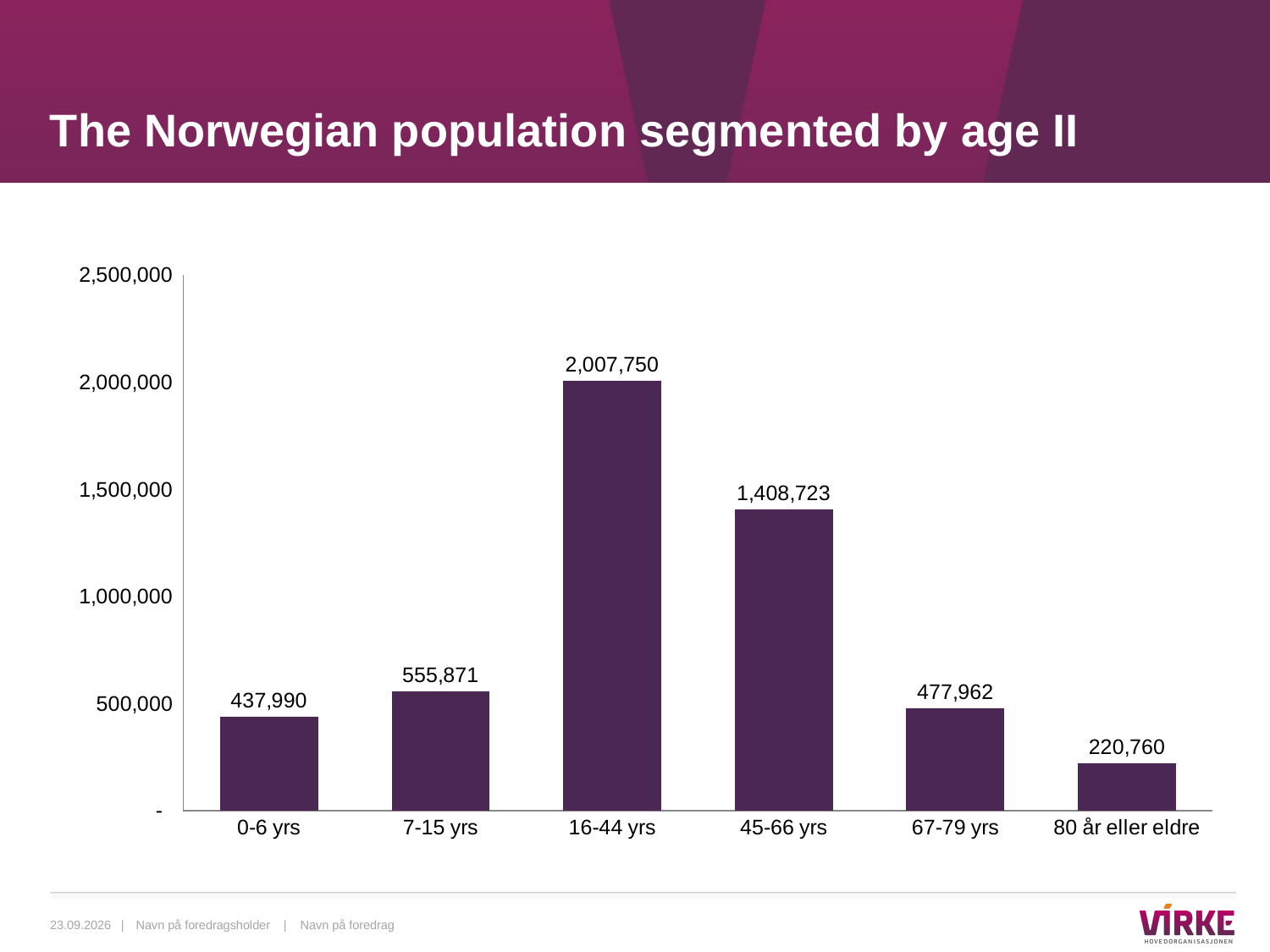
What is the value for the 80 år eller eldre age group? 220,760 What is the difference between the values for 16-44 yrs and 45-66 yrs? 599,027 Is the value for 45-66 yrs greater or less than 1,500,000? less Which is larger, the value for 7-15 yrs or the value for 67-79 yrs? 7-15 yrs What is the value for the 0-6 yrs age group? 437,990 How many age groups are shown on the chart? 6 What is the title of the slide? The Norwegian population segmented by age II What is the difference between the values for 7-15 yrs and 0-6 yrs? 117,881 Which age group has the highest value? 16-44 yrs What kind of chart is shown on the slide? bar chart What is the value for the 16-44 yrs age group? 2,007,750 Which age group has the lowest value? 80 år eller eldre